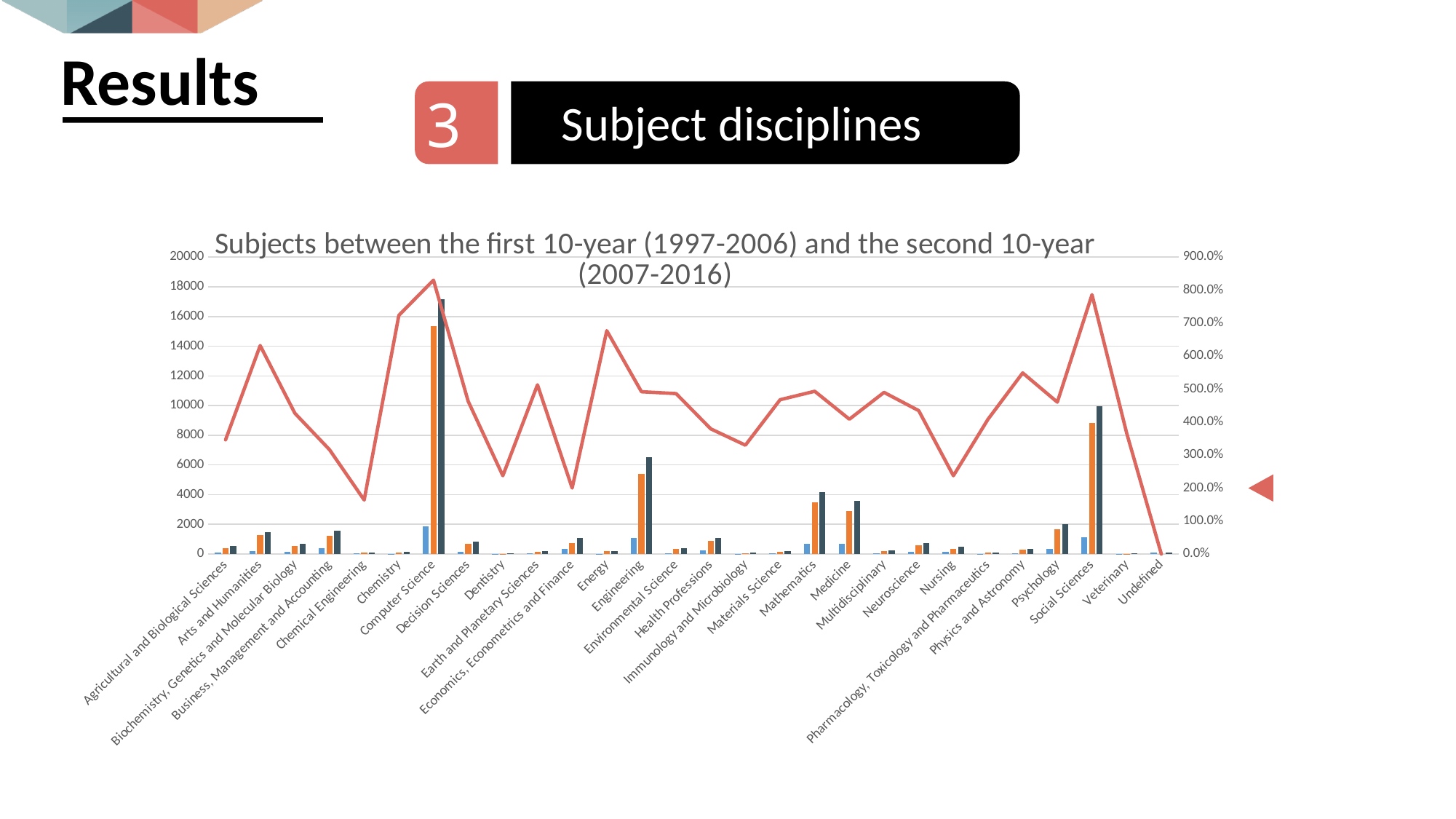
Does the red line rise or fall between Social Sciences and Undefined? Fall At which subject does the red line reach its lowest point? Undefined Which subject has the tallest bars? Computer Science Is the value of the dark bar for Engineering greater or less than 6000? greater Is the value of the red line at Computer Science greater or less than 800.0%? greater Is the value of the tallest dark bar for Computer Science greater or less than 16000? greater What is the title of the chart? Subjects between the first 10-year (1997-2006) and the second 10-year (2007-2016) At which subject does the red line reach its highest point? Computer Science How many subject categories are shown along the x axis? 28 Which has the taller dark bar, Engineering or Medicine? Engineering What kind of chart is shown on the slide? A combined bar and line chart